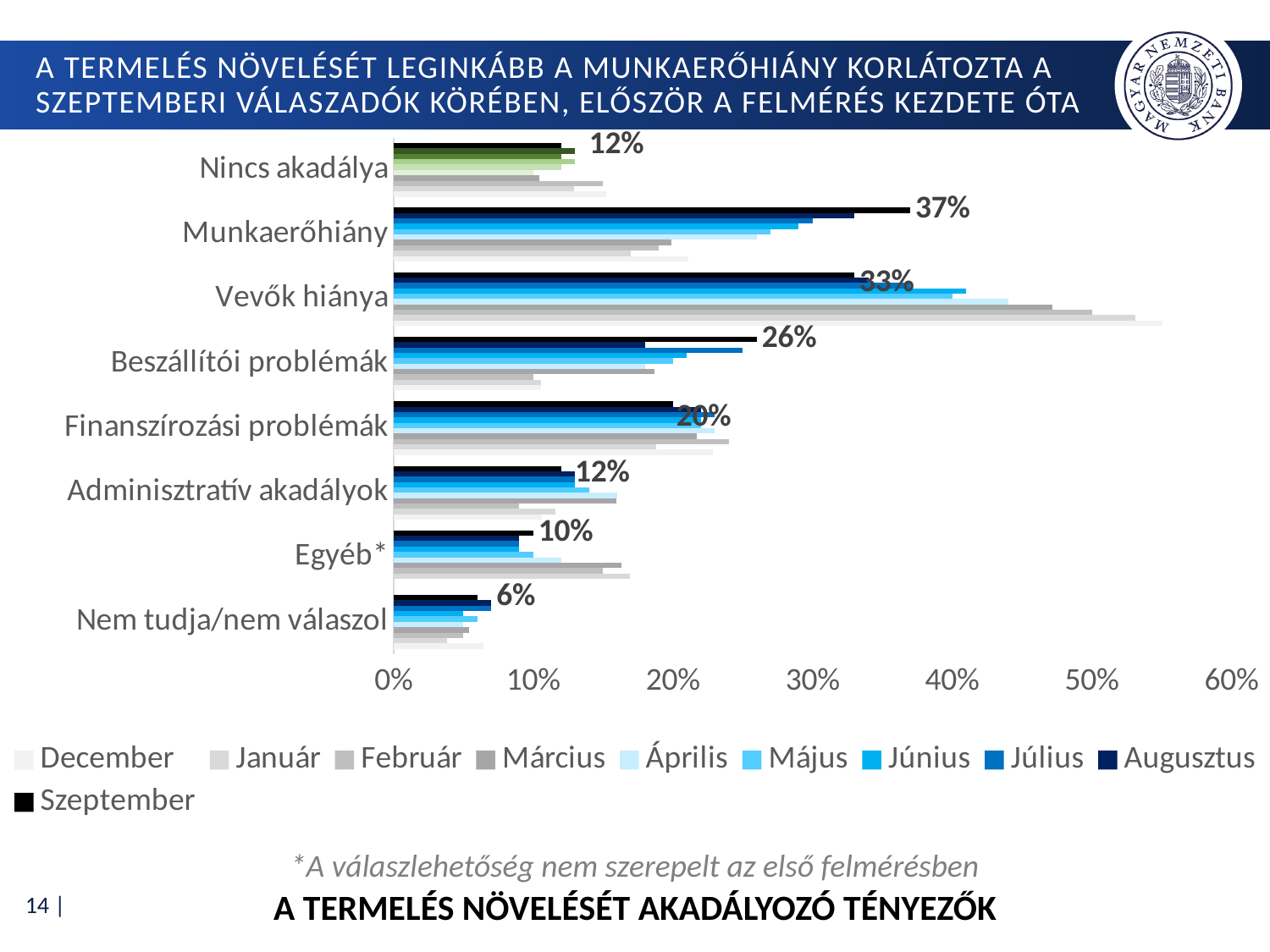
What is the Szeptember value for Munkaerőhiány? 37% What is the Szeptember value for Vevők hiánya? 33% Is the December value for Vevők hiánya greater or less than 50%? greater What is the difference between the Szeptember values for Munkaerőhiány and Vevők hiánya? 4% What is the Szeptember value for Nem tudja/nem válaszol? 6% Which category has the highest Szeptember value? Munkaerőhiány Which has a larger Szeptember value, Beszállítói problémák or Finanszírozási problémák? Beszállítói problémák Which category has the lowest Szeptember value? Nem tudja/nem válaszol What is the Szeptember value for Beszállítói problémák? 26% How many categories are shown on the chart? 8 How many series does the legend list? 10 What kind of chart is shown on the slide? Bar chart